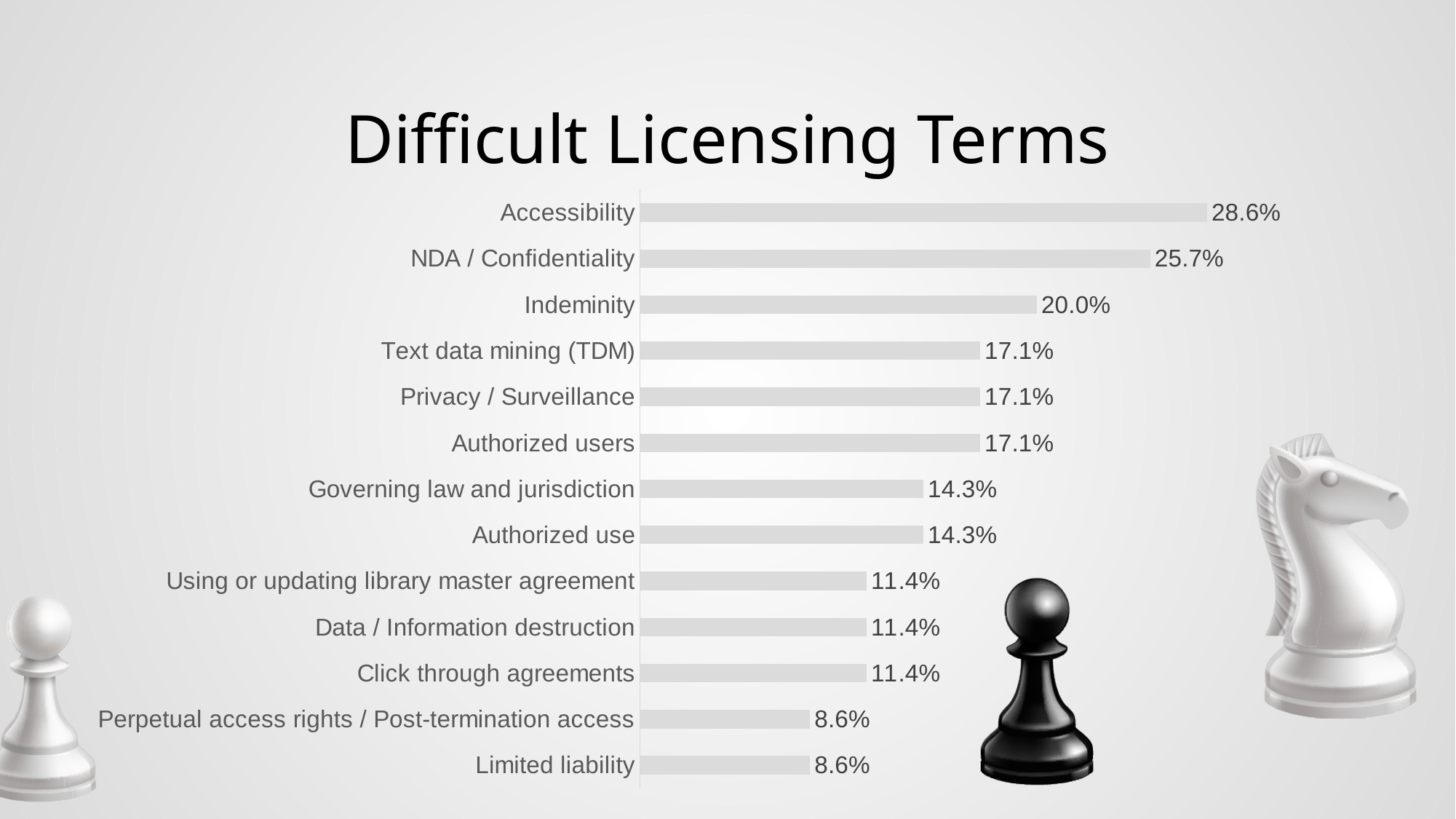
What is the difference between the values for Accessibility and Indeminity? 8.6% How many categories are shown in the chart? 13 What is the value for Text data mining (TDM)? 17.1% Which category has the highest value? Accessibility What is the value for Accessibility? 28.6% What is the value for NDA / Confidentiality? 25.7% What is the title of the slide? Difficult Licensing Terms What is the value for Governing law and jurisdiction? 14.3% What is the difference between the values for NDA / Confidentiality and Limited liability? 17.1% What is the value for Click through agreements? 11.4% Which is larger, the value for Indeminity or the value for Authorized use? Indeminity What kind of chart is shown on the slide? Bar chart